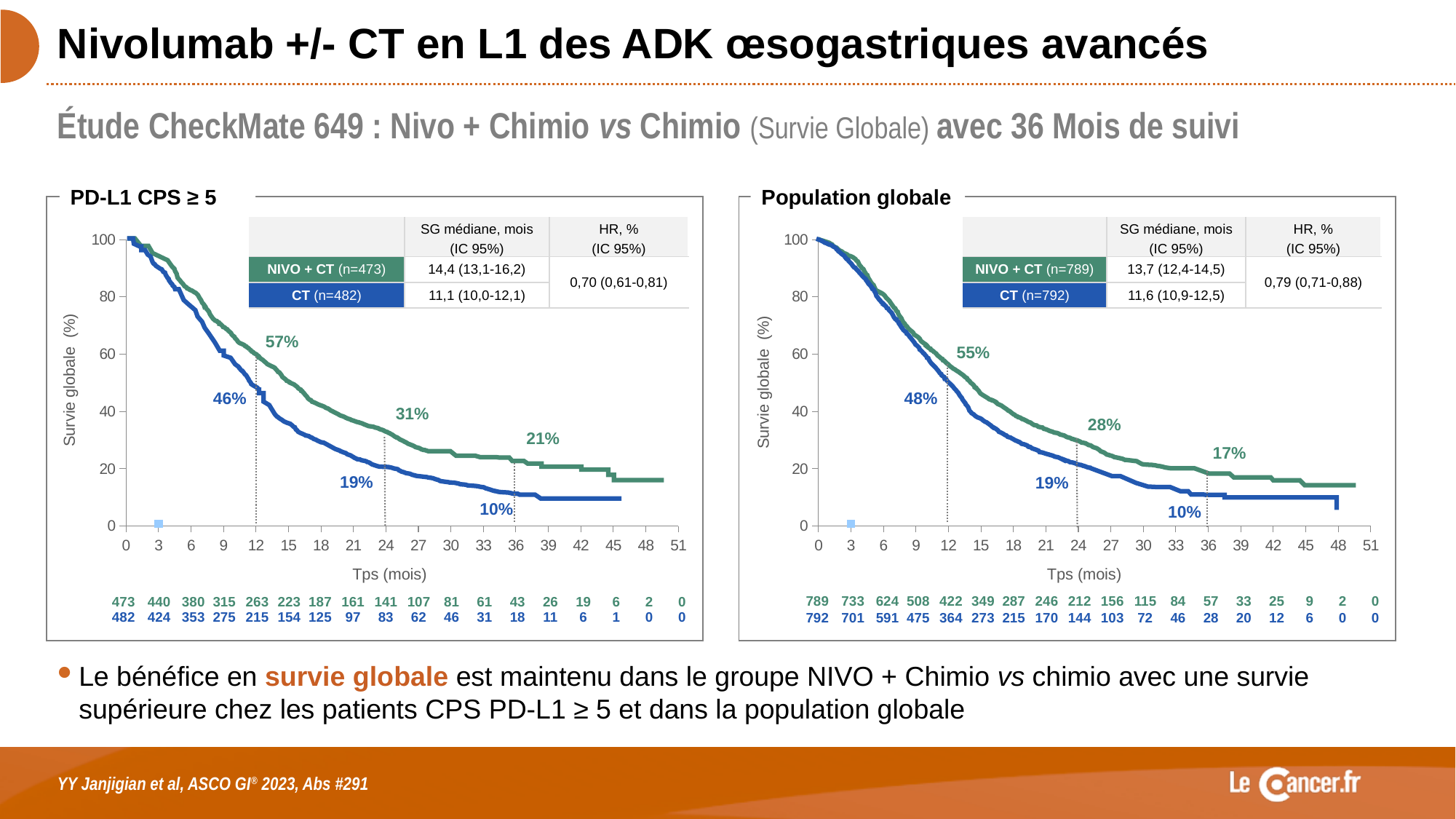
In the PD-L1 CPS ≥ 5 chart, what is the overall survival rate for CT at 12 months? 46% In the Population globale chart, what is the overall survival rate for CT at 36 months? 10% In the Population globale chart, what is the difference between the NIVO + CT and CT survival rates at 12 months? 7% In the PD-L1 CPS ≥ 5 chart, what is the difference between the NIVO + CT and CT survival rates at 24 months? 12% In the Population globale chart, what is the hazard ratio shown in the table? 0,79 (0,71-0,88) In the PD-L1 CPS ≥ 5 chart, what is the median overall survival for NIVO + CT in months? 14,4 In the Population globale chart, which arm has the higher survival rate at 36 months, NIVO + CT or CT? NIVO + CT In the Population globale chart, what is the overall survival rate for NIVO + CT at 24 months? 28% In the Population globale chart, how many patients were at risk in the CT arm at 0 months? 792 In the PD-L1 CPS ≥ 5 chart, do the survival curves rise or fall as time increases? fall In the PD-L1 CPS ≥ 5 chart, what is the overall survival rate for NIVO + CT at 36 months? 21% In the PD-L1 CPS ≥ 5 chart, what is the overall survival rate for NIVO + CT at 12 months? 57%